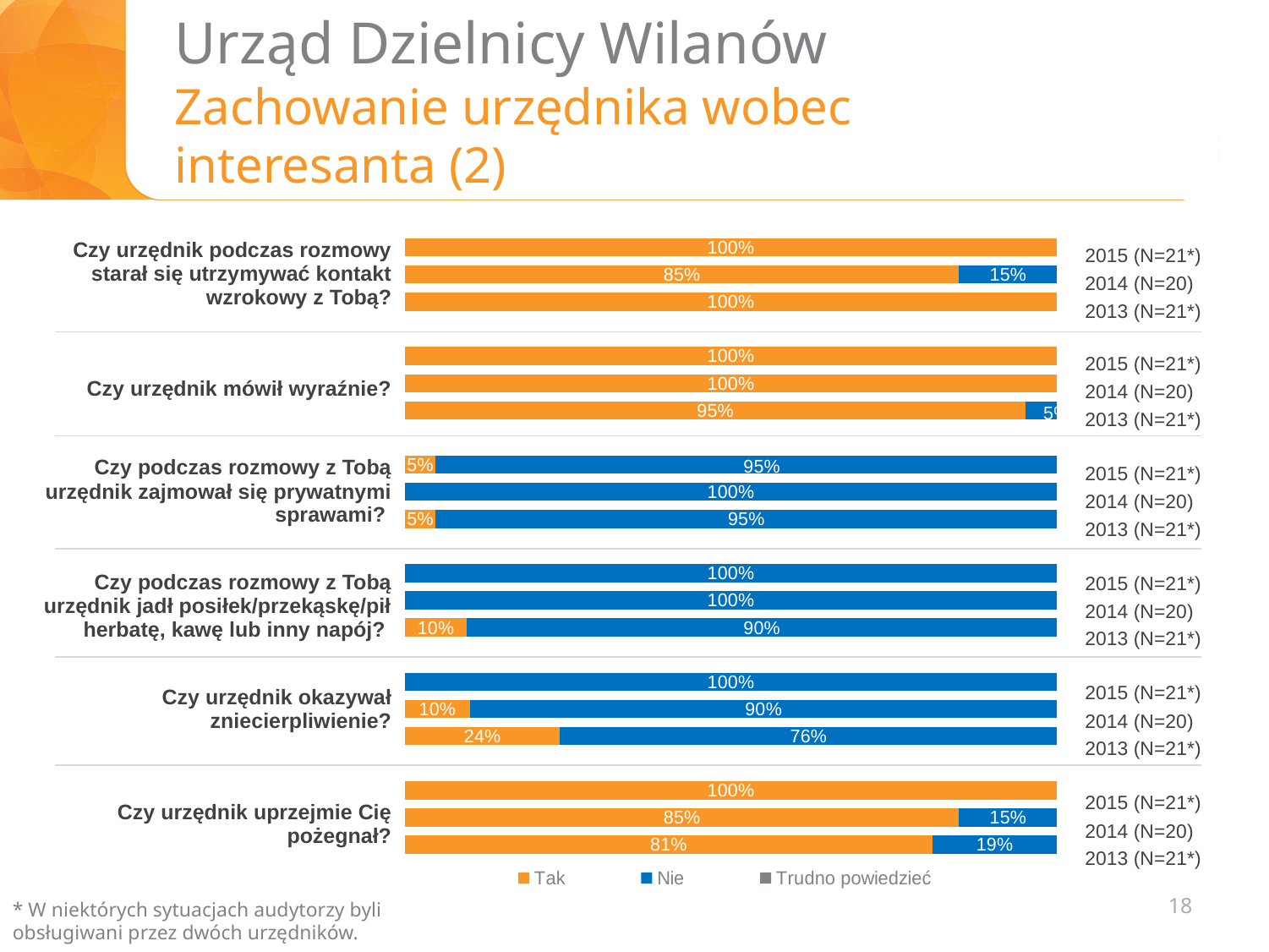
For the question "Czy urzędnik okazywał zniecierpliwienie?", which year has the larger "Tak" value, 2014 (N=20) or 2013 (N=21*)? 2013 (N=21*) How many series does the legend list? 3 What are the legend entries of the chart? Tak, Nie, Trudno powiedzieć For the question "Czy urzędnik uprzejmie Cię pożegnał?", what is the difference in percentage points between the "Tak" values for 2014 (N=20) and 2013 (N=21*)? 4 For the question "Czy urzędnik mówił wyraźnie?", what is the "Tak" value for 2013 (N=21*)? 95% For the question "Czy urzędnik uprzejmie Cię pożegnał?", what is the "Nie" value for 2013 (N=21*)? 19% For the question "Czy podczas rozmowy z Tobą urzędnik jadł posiłek/przekąskę/pił herbatę, kawę lub inny napój?", what is the "Tak" value for 2013 (N=21*)? 10% For the question "Czy urzędnik podczas rozmowy starał się utrzymywać kontakt wzrokowy z Tobą?", what is the "Nie" value for 2014 (N=20)? 15% What kind of chart is shown on the slide? bar chart For the question "Czy urzędnik podczas rozmowy starał się utrzymywać kontakt wzrokowy z Tobą?", what is the "Tak" value for 2014 (N=20)? 85% How many survey questions are shown on the chart? 6 For the question "Czy urzędnik okazywał zniecierpliwienie?", what is the "Tak" value for 2013 (N=21*)? 24%